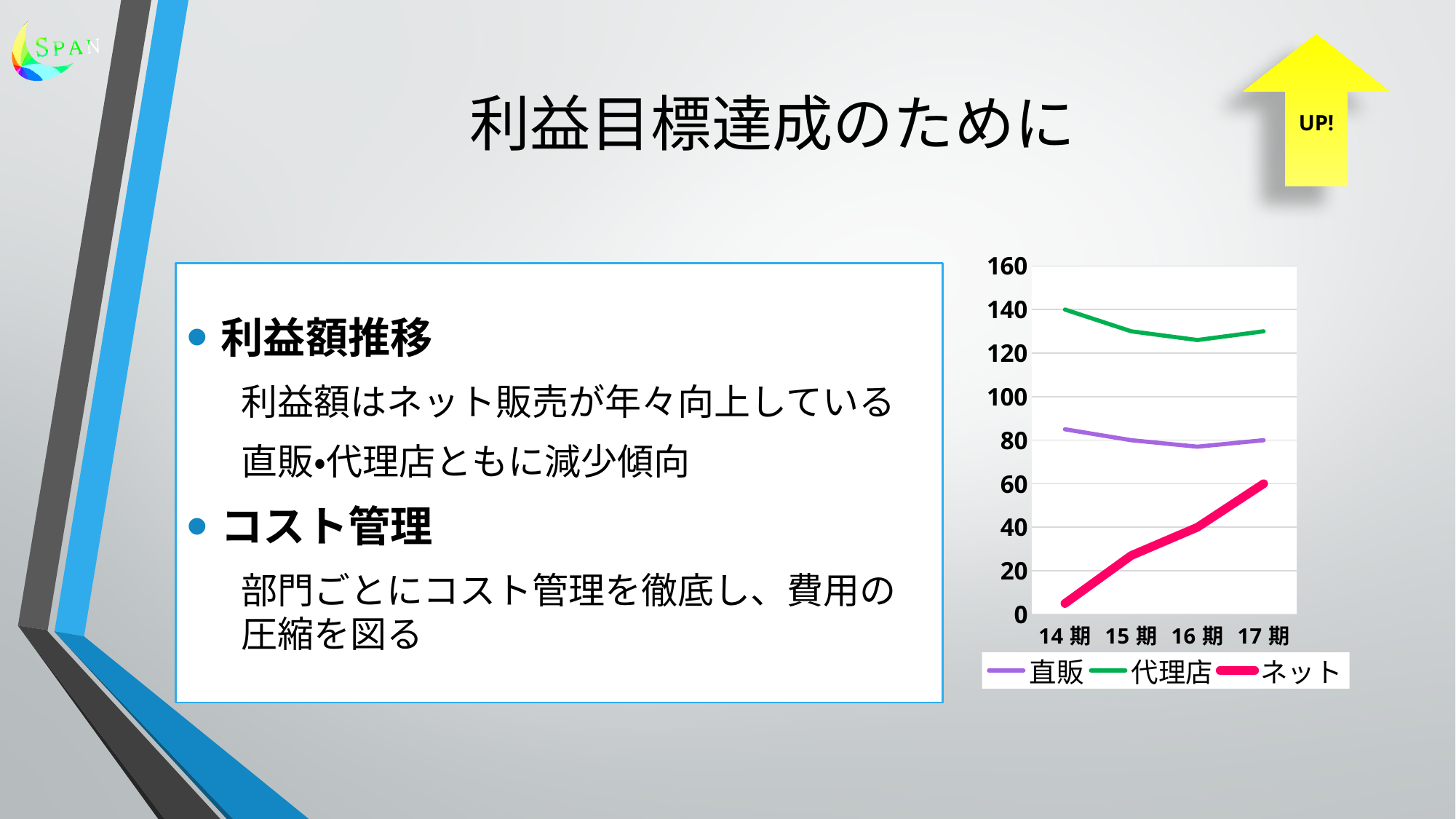
How many periods are shown on the x axis of the chart? 4 Which series has the lowest value at 14期? ネット Is the value for 代理店 at 16期 greater or less than 120? greater Which series has the highest values across all periods in the chart? 代理店 What kind of chart is shown on the slide? line chart Does the 代理店 series rise or fall from 14期 to 16期? fall Is the value for ネット at 15期 greater or less than 40? less Is the value for 直販 at 14期 greater or less than 80? greater How many series does the chart legend list? 3 Which series is drawn in green in the chart? 代理店 At 17期, which is larger: the value for 直販 or the value for ネット? 直販 Does the ネット series rise or fall from 14期 to 17期? rise